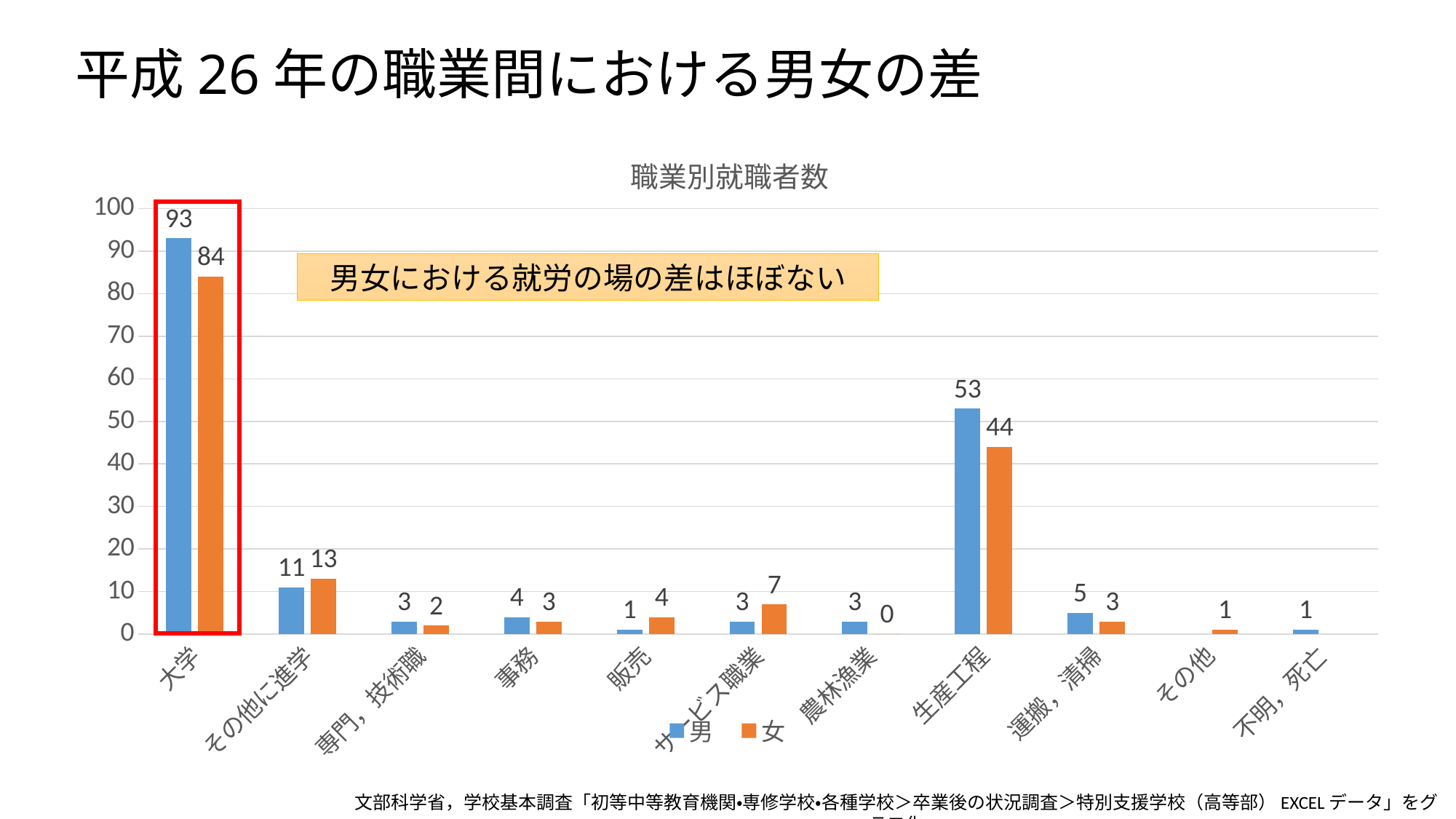
What is the title of the chart? 職業別就職者数 What is the value for 女 in the サービス職業 category? 7 In the 運搬，清掃 category, which is larger, 男 or 女? 男 What is the difference between the 男 and 女 values in the 大学 category? 9 What is the value for 男 in the 大学 category? 93 What kind of chart is shown? bar chart How many series does the legend list? 2 What is the difference between the 男 and 女 values in the 生産工程 category? 9 How many categories are shown on the x axis? 11 Which category has the highest value for 男? 大学 What is the value for 女 in the 生産工程 category? 44 In the その他に進学 category, which is larger, 男 or 女? 女